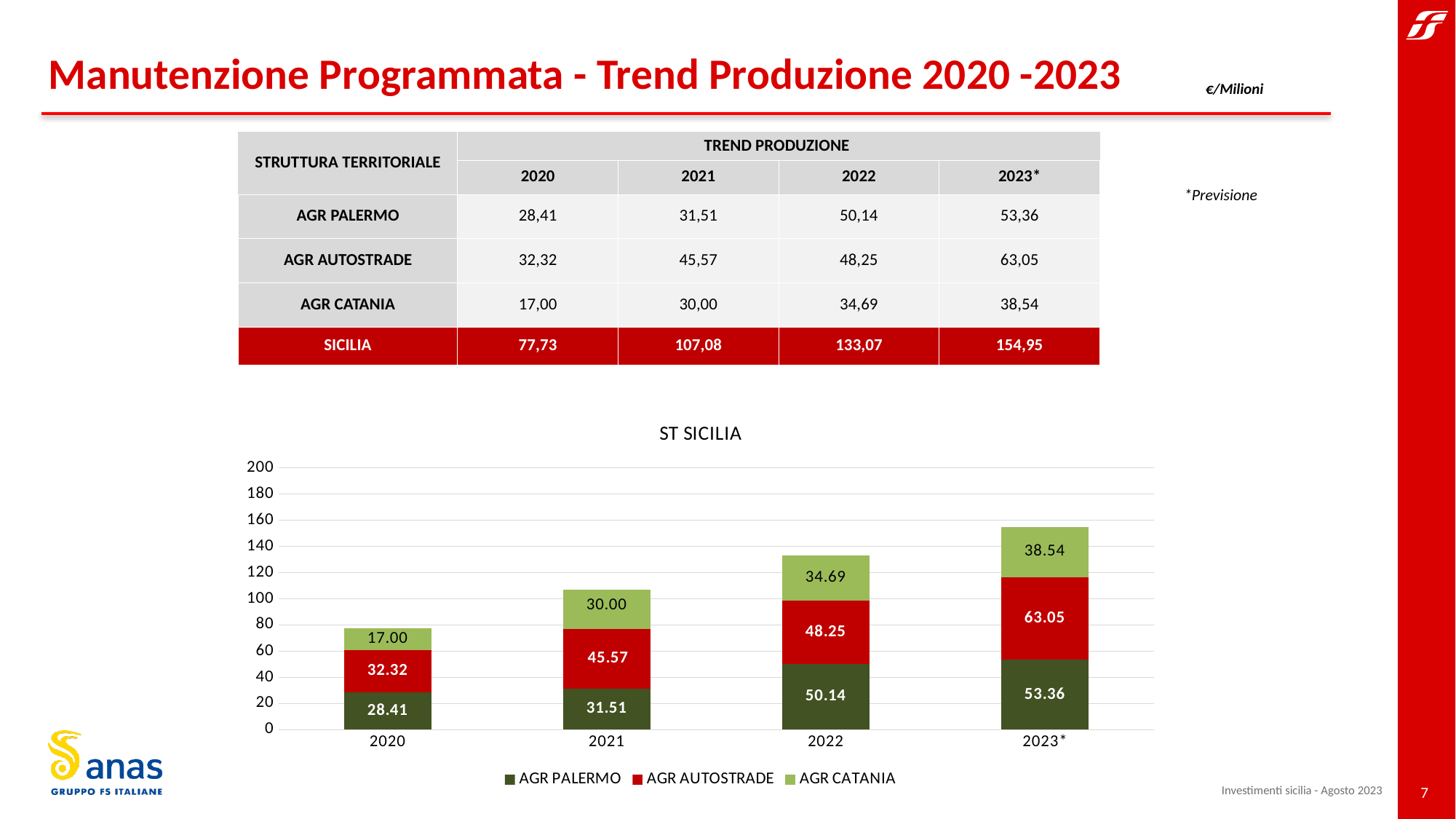
In the ST SICILIA chart, what is the total of the stacked bar for 2020? 77.73 In the ST SICILIA chart, what is the difference between the AGR PALERMO values for 2022 and 2021? 18.63 How many series does the legend of the ST SICILIA chart list? 3 In the ST SICILIA chart, what is the value for AGR AUTOSTRADE in 2021? 45.57 In the ST SICILIA chart, which is larger in 2022: AGR PALERMO or AGR AUTOSTRADE? AGR PALERMO In the ST SICILIA chart, what is the value for AGR PALERMO in 2023*? 53.36 In the ST SICILIA chart, which year has the highest value for AGR AUTOSTRADE? 2023* In the ST SICILIA chart, which year has the lowest value for AGR CATANIA? 2020 In the ST SICILIA chart, is the total height of the 2023* bar greater or less than 140? greater In the ST SICILIA chart, what is the value for AGR CATANIA in 2022? 34.69 What type of chart is shown under the title ST SICILIA? Stacked bar chart In the ST SICILIA chart, do the total bar heights rise or fall from 2020 to 2023*? Rise